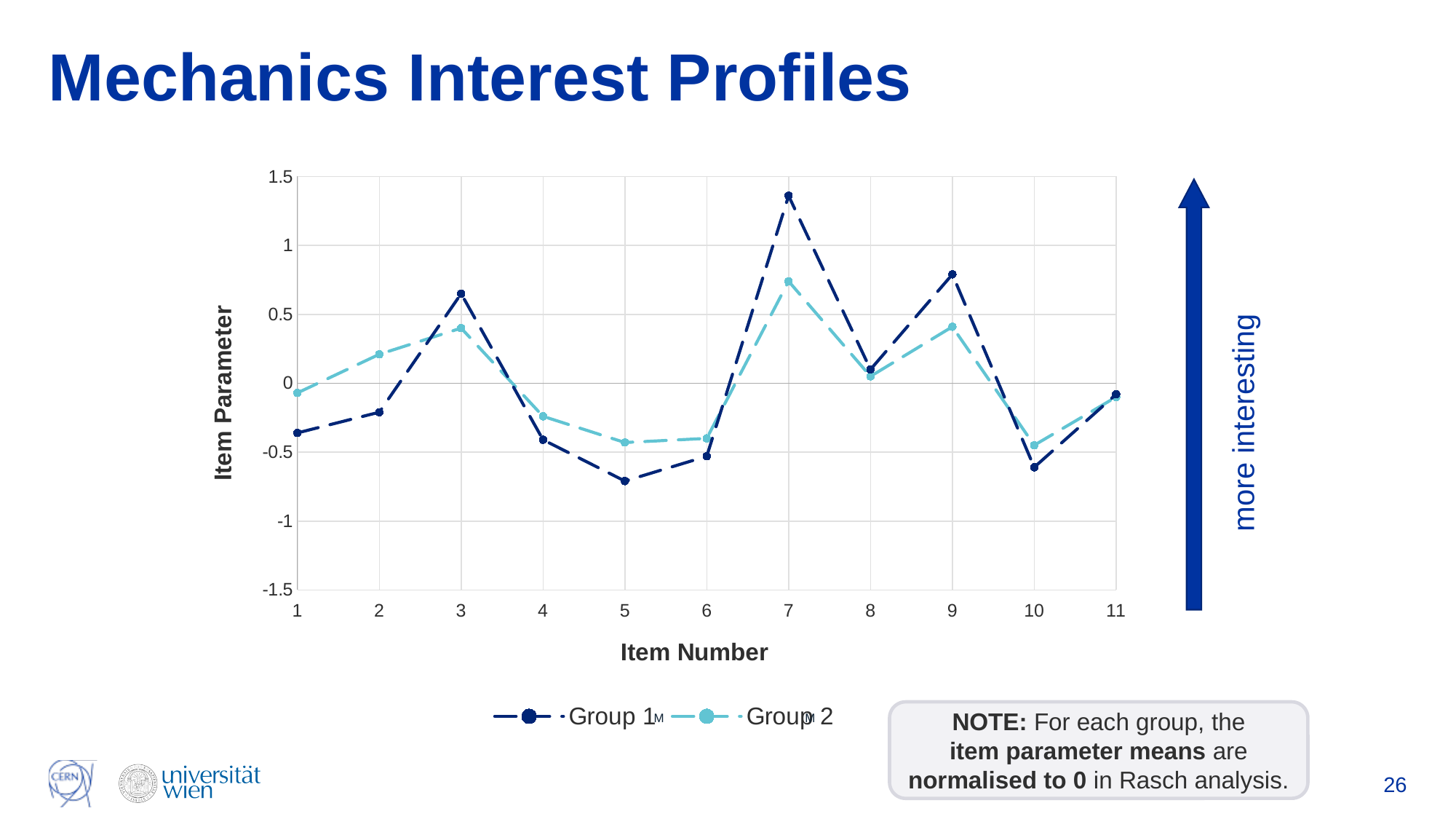
At which item number does Group 1 reach its highest item parameter? 7 Is the Group 2 value at item 3 greater or less than 0.5? less At item 7, which group has the larger item parameter? Group 1 What is the label of the y axis? Item Parameter What kind of chart is shown on the slide? line chart How many item numbers are plotted along the x axis? 11 Is the Group 1 value at item 7 greater or less than 1? greater At item 2, which group has the larger item parameter? Group 2 At which item number does Group 1 reach its lowest item parameter? 5 How many series does the legend list? 2 Is the Group 1 value at item 5 greater or less than -0.5? less At which item number does Group 2 reach its highest item parameter? 7